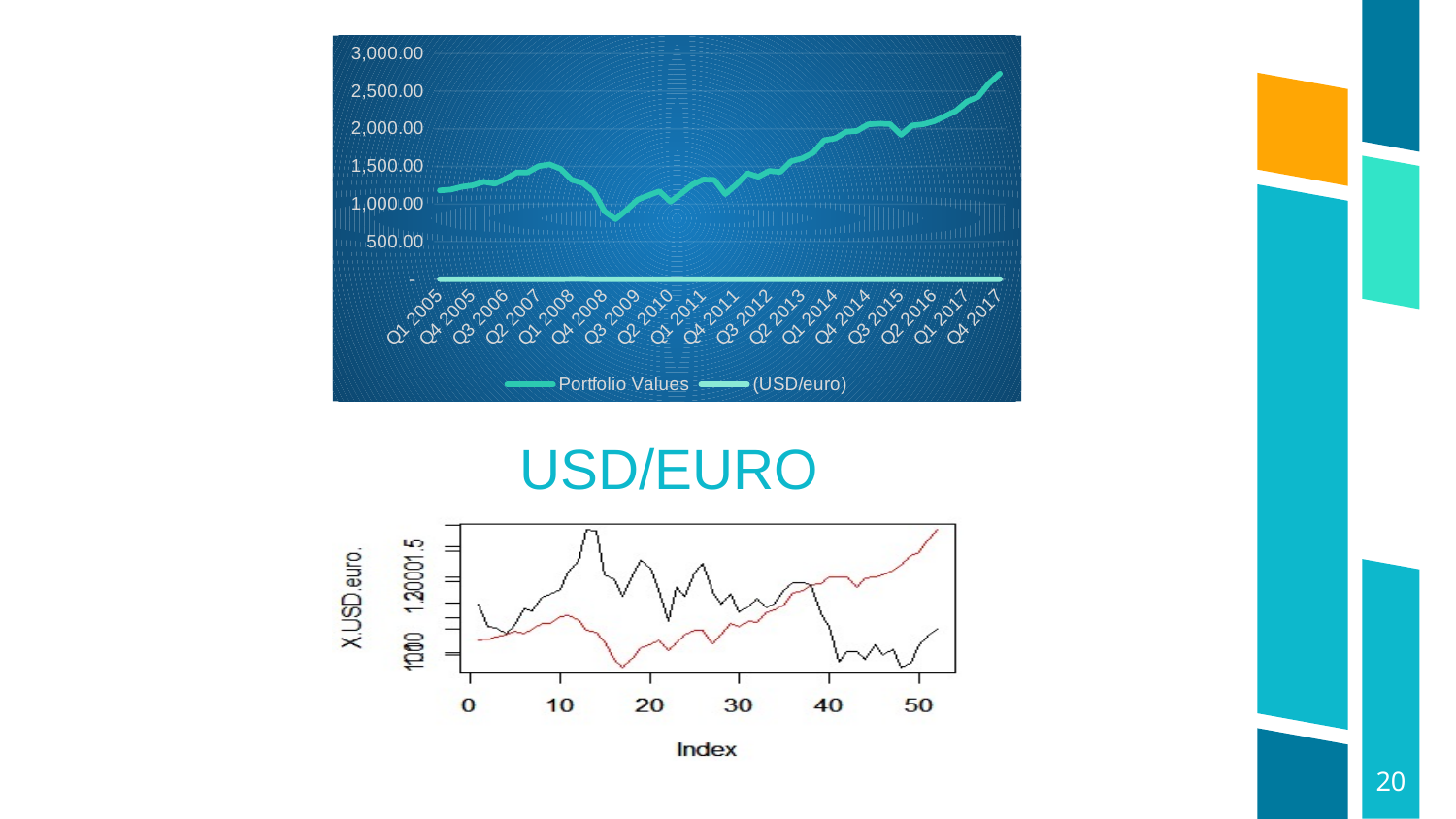
In the top chart, is the Portfolio Values value at Q4 2017 greater or less than 2,500.00? greater What is the title of the bottom chart? USD/EURO In the top chart, at which quarter does the Portfolio Values series reach its highest point? Q4 2017 In the bottom chart titled USD/EURO, what kind of chart is shown? line chart In the top chart, what are the two series named in the legend? Portfolio Values and (USD/euro) In the top chart, what kind of chart is shown? line chart In the top chart, how many series does the legend list? 2 In the top chart, which is larger for Portfolio Values: the value at Q1 2005 or the value at Q4 2017? Q4 2017 In the top chart, is the Portfolio Values value at Q1 2005 greater or less than 1,000.00? greater In the top chart, does the Portfolio Values series overall rise or fall from Q1 2005 to Q4 2017? rise